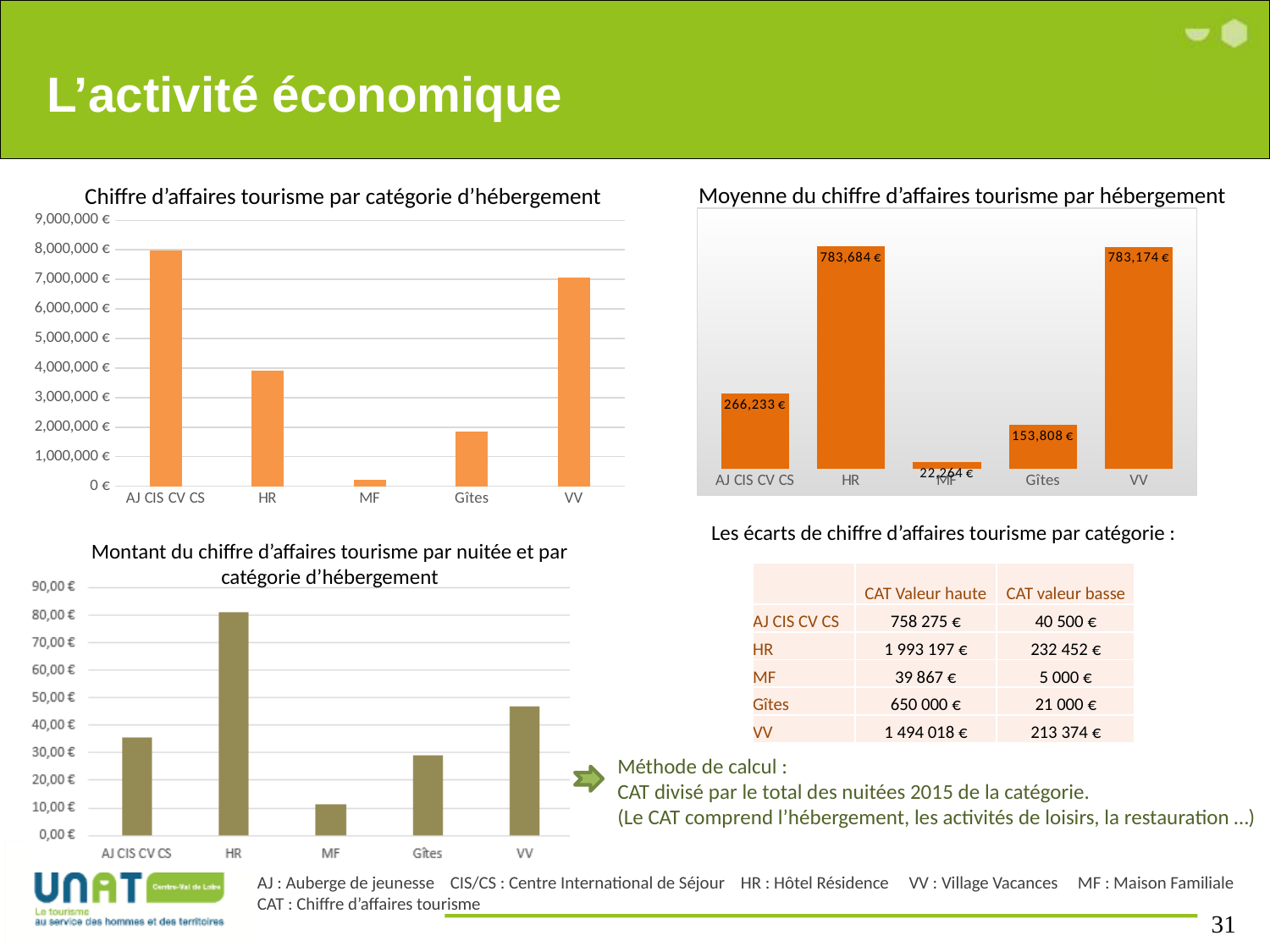
In the 'Chiffre d'affaires tourisme par catégorie d'hébergement' chart, which category has the highest value? AJ CIS CV CS In the 'Montant du chiffre d'affaires tourisme par nuitée et par catégorie d'hébergement' chart, is the value for VV greater or less than 40,00 €? greater In the 'Chiffre d'affaires tourisme par catégorie d'hébergement' chart, which category has the lowest value? MF How many categories are shown in the 'Chiffre d'affaires tourisme par catégorie d'hébergement' chart? 5 In the 'Moyenne du chiffre d'affaires tourisme par hébergement' chart, what is the difference between the values for HR and AJ CIS CV CS? 517,451 € In the 'Moyenne du chiffre d'affaires tourisme par hébergement' chart, what is the value for MF? 22,264 € In the 'Moyenne du chiffre d'affaires tourisme par hébergement' chart, what is the value for HR? 783,684 € In the 'Moyenne du chiffre d'affaires tourisme par hébergement' chart, which category has the lowest value? MF What kind of chart is the 'Chiffre d'affaires tourisme par catégorie d'hébergement' chart? bar chart In the 'Chiffre d'affaires tourisme par catégorie d'hébergement' chart, is the value for VV greater or less than 6,000,000 €? greater In the 'Moyenne du chiffre d'affaires tourisme par hébergement' chart, which is larger: AJ CIS CV CS or Gîtes? AJ CIS CV CS In the 'Montant du chiffre d'affaires tourisme par nuitée et par catégorie d'hébergement' chart, which category has the highest value? HR